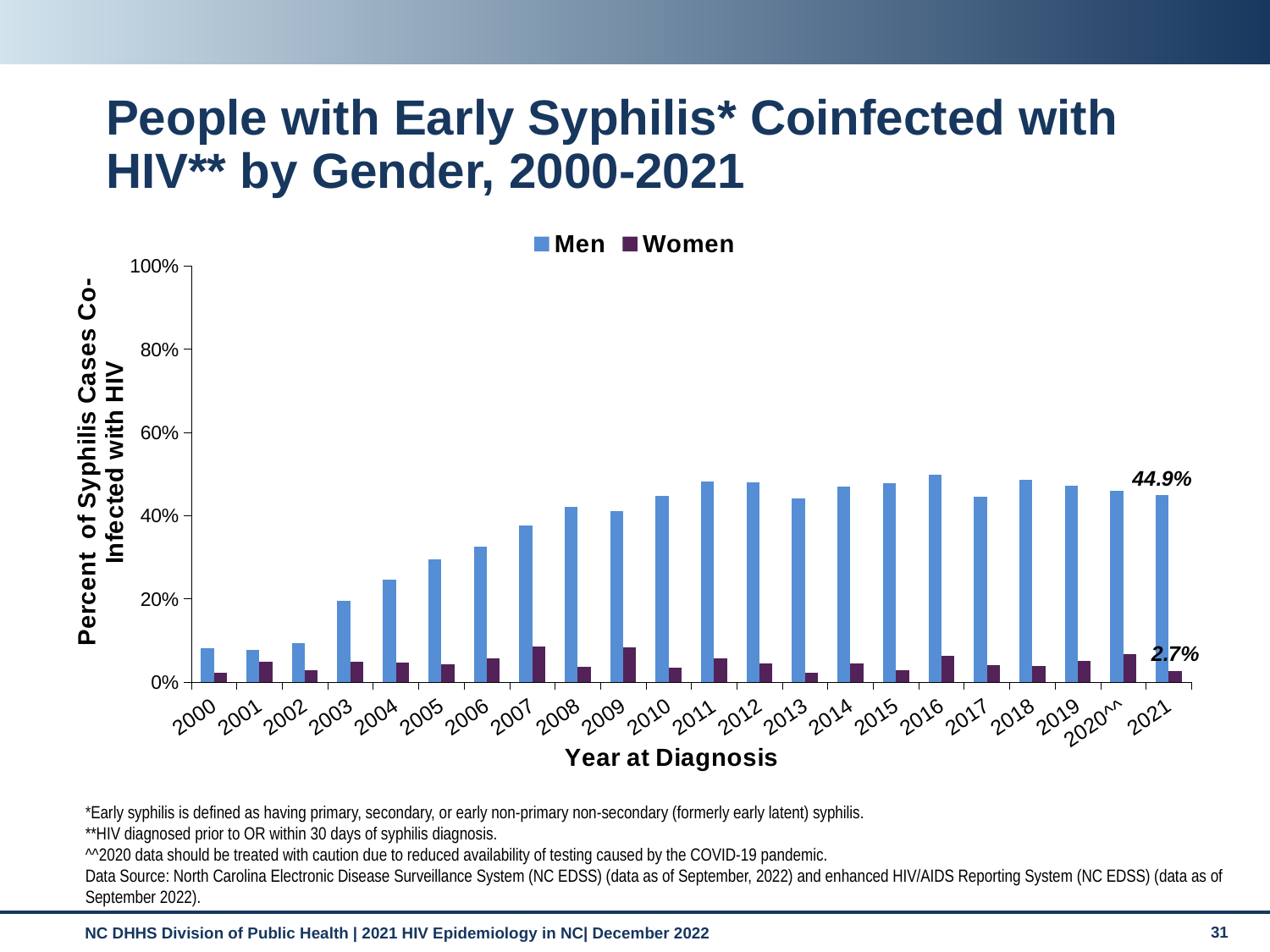
In 2021, which is larger, the value for Men or the value for Women? Men How many series does the legend list? 2 Is the value for Men in 2016 greater or less than 40%? greater What is the title of the x axis? Year at Diagnosis What kind of chart is shown on the slide? Bar chart Is the value for Men in 2000 greater or less than 20%? less What is the difference between the Men and Women values in 2021? 42.2 percentage points What is the value for Women in 2021? 2.7% How many years are shown on the x axis? 22 Do the values for Men generally rise or fall from 2000 to 2011? rise Which is larger, the value for Men in 2000 or the value for Men in 2010? 2010 What is the value for Men in 2021? 44.9%